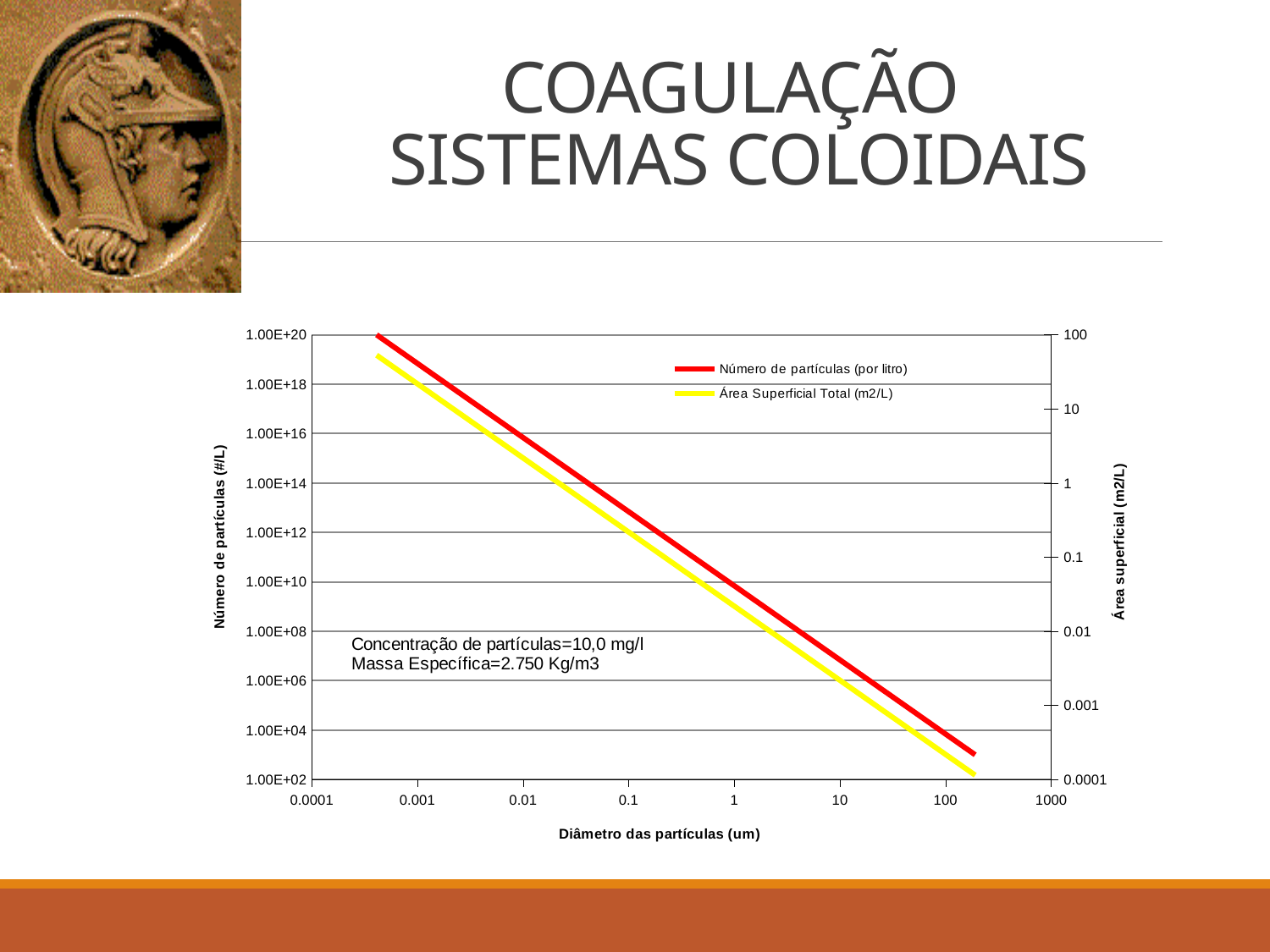
Do the values of Área Superficial Total (m2/L) rise or fall as the particle diameter increases along the x axis? fall What kind of chart is shown on the slide? line chart Is the value of Número de partículas (por litro) at a diameter of 100 um greater or less than 1.00E+06? less Do the values of Número de partículas (por litro) rise or fall as the particle diameter increases along the x axis? fall Is the value of Número de partículas (por litro) at a diameter of 0.001 um greater or less than 1.00E+16? greater Is the value of Área Superficial Total (m2/L) at a diameter of 100 um greater or less than 0.001? less What is the title of the x axis? Diâmetro das partículas (um) How many series does the chart legend list? 2 Which series is drawn in red? Número de partículas (por litro)